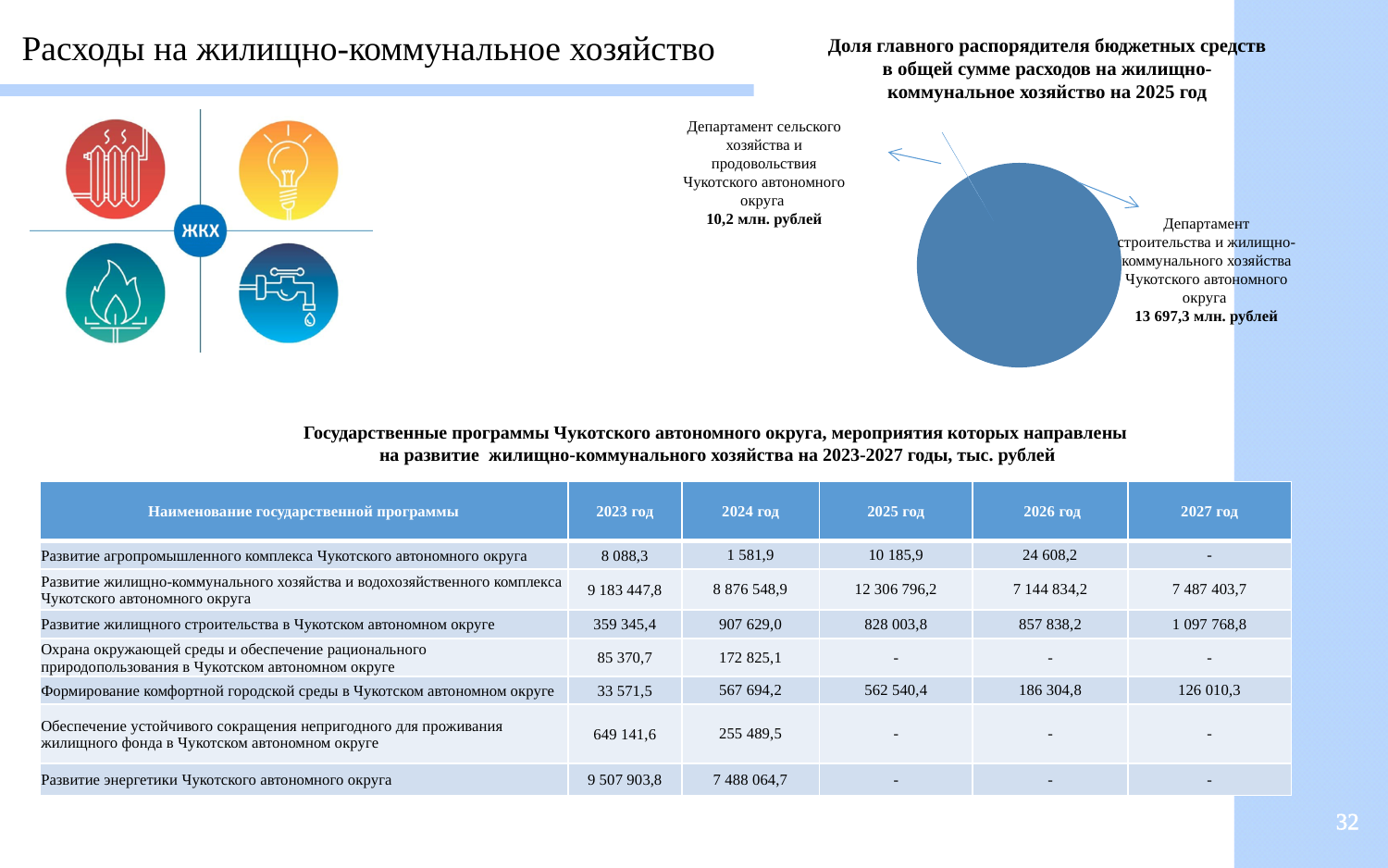
What is the title of the pie chart? Доля главного распорядителя бюджетных средств в общей сумме расходов на жилищно-коммунальное хозяйство на 2025 год In the pie chart, which is larger: the value for Департамент сельского хозяйства или Департамент строительства и жилищно-коммунального хозяйства? Департамент строительства и жилищно-коммунального хозяйства How many slices does the pie chart have? 2 What value is shown for Департамент строительства и жилищно-коммунального хозяйства Чукотского автономного округа in the pie chart? 13 697,3 млн. рублей What is the total of the two values shown in the pie chart? 13 707,5 млн. рублей For which year does the pie chart show the share of budget administrators? 2025 What value is shown for Департамент сельского хозяйства и продовольствия Чукотского автономного округа in the pie chart? 10,2 млн. рублей Which department has the smallest slice in the pie chart? Департамент сельского хозяйства и продовольствия Чукотского автономного округа What kind of chart is shown on the slide? Pie chart Which department has the largest slice in the pie chart? Департамент строительства и жилищно-коммунального хозяйства Чукотского автономного округа What is the difference between the values of Департамент строительства и жилищно-коммунального хозяйства and Департамент сельского хозяйства in the pie chart? 13 687,1 млн. рублей